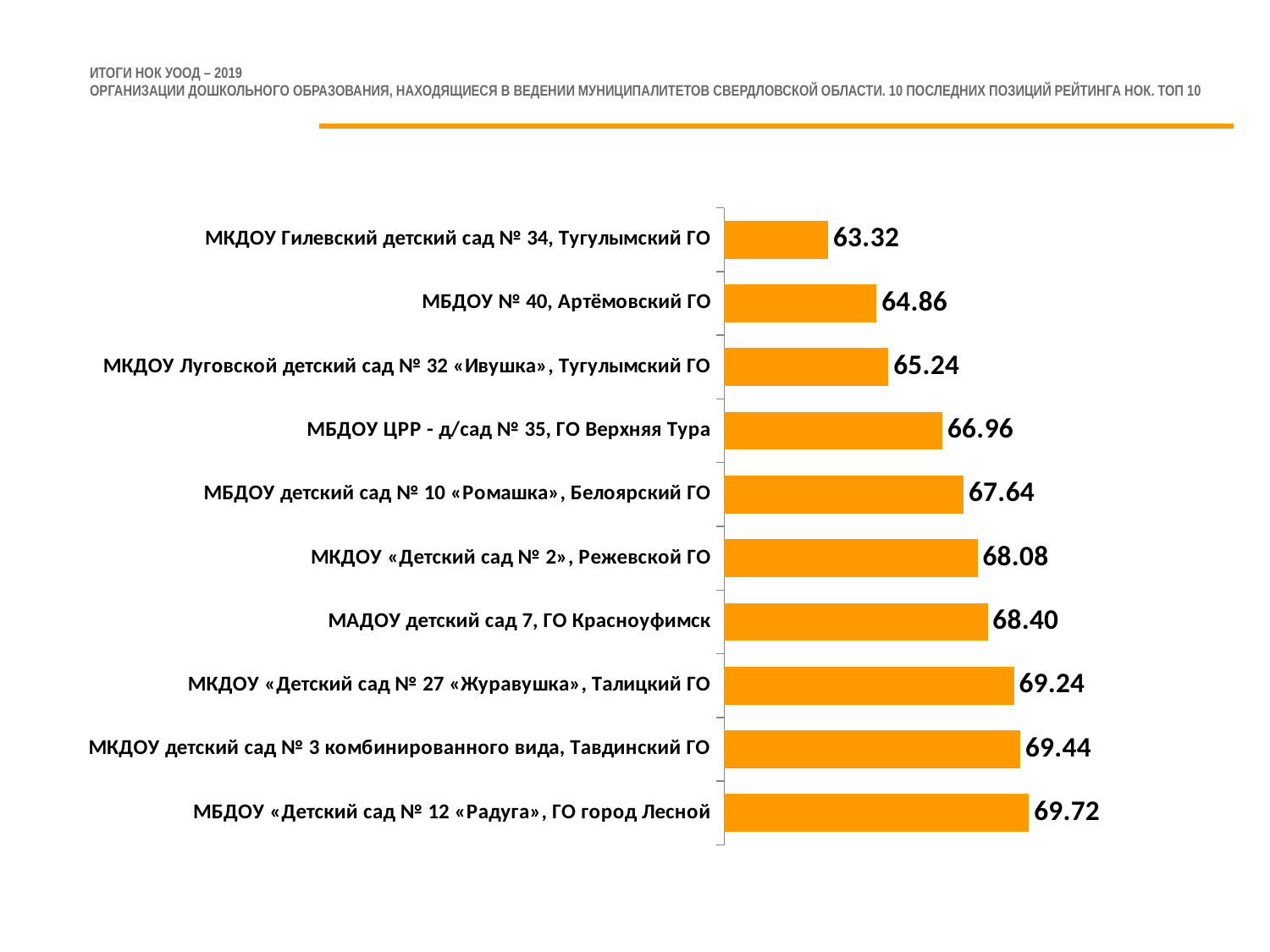
What kind of chart is shown on the slide? Bar chart What colour are the bars on the chart? Orange How many organisations are shown on the chart? 10 What value is shown for МАДОУ детский сад 7, ГО Красноуфимск? 68.40 What value is shown for МБДОУ № 40, Артёмовский ГО? 64.86 What value is shown for МБДОУ ЦРР - д/сад № 35, ГО Верхняя Тура? 66.96 Which has a larger value: МКДОУ Луговской детский сад № 32 «Ивушка», Тугулымский ГО or МКДОУ «Детский сад № 27 «Журавушка», Талицкий ГО? МКДОУ «Детский сад № 27 «Журавушка», Талицкий ГО What is the difference between the values for МБДОУ «Детский сад № 12 «Радуга», ГО город Лесной and МКДОУ Гилевский детский сад № 34, Тугулымский ГО? 6.40 Do the values increase or decrease going from the top bar to the bottom bar? Increase Which organisation has the highest value on the chart? МБДОУ «Детский сад № 12 «Радуга», ГО город Лесной What is the difference between the values for МКДОУ «Детский сад № 2», Режевской ГО and МБДОУ детский сад № 10 «Ромашка», Белоярский ГО? 0.44 Which organisation has the lowest value on the chart? МКДОУ Гилевский детский сад № 34, Тугулымский ГО